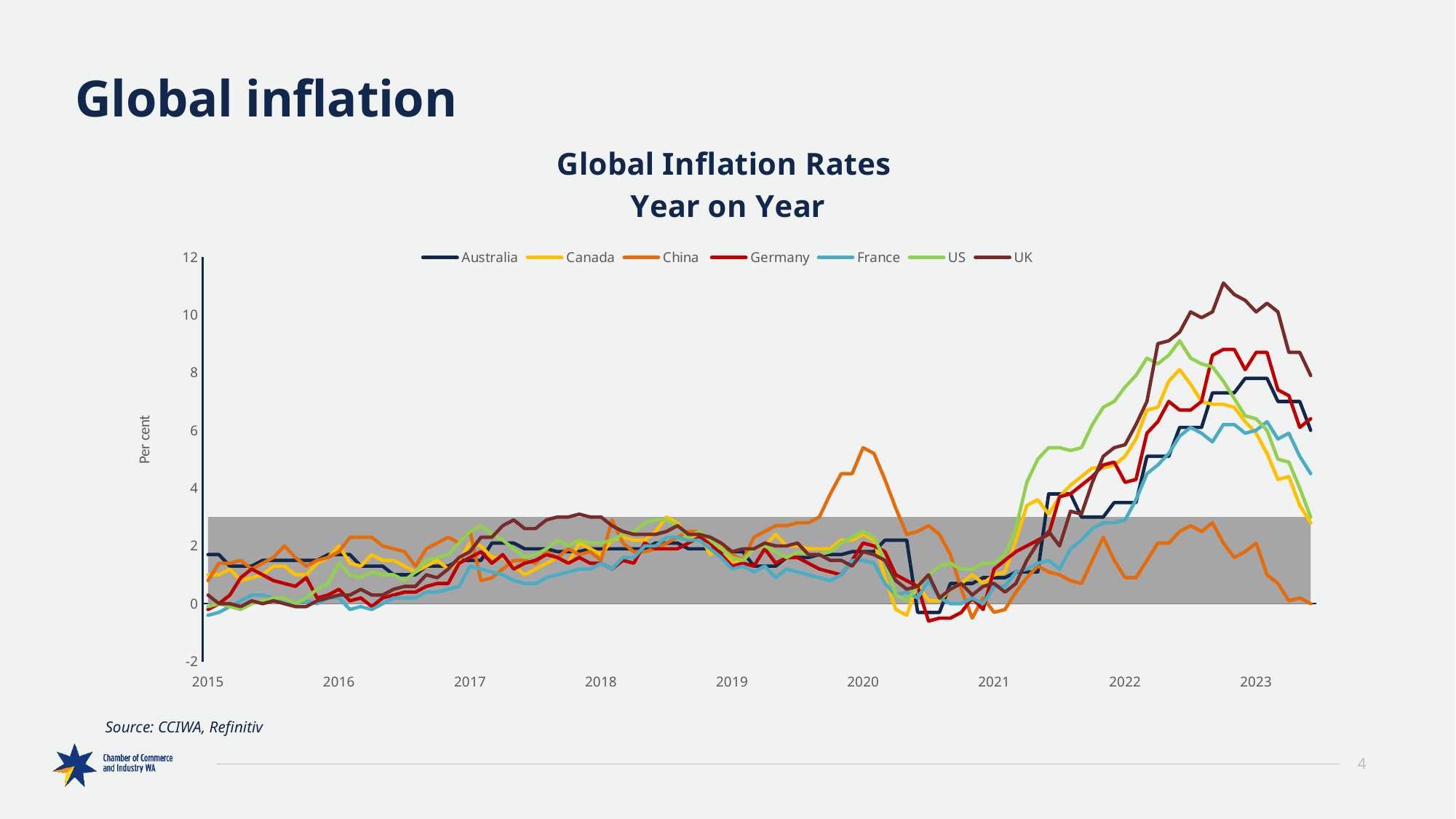
What label is shown on the vertical axis? Per cent Does the UK series rise or fall between 2021 and 2022? rise Is the peak value for China in 2020 greater or less than 4? greater Is the peak value for Canada greater or less than 6? greater How many series does the legend list? 7 At the right-hand end of the chart, which series is higher, UK or China? UK What kind of chart is shown on the slide? line chart Which series reaches the highest peak on the chart? UK How many year labels are shown on the horizontal axis? 9 Between which two values on the vertical axis does the grey shaded band lie? 0 and 3 Is the peak value for the UK greater or less than 10? greater